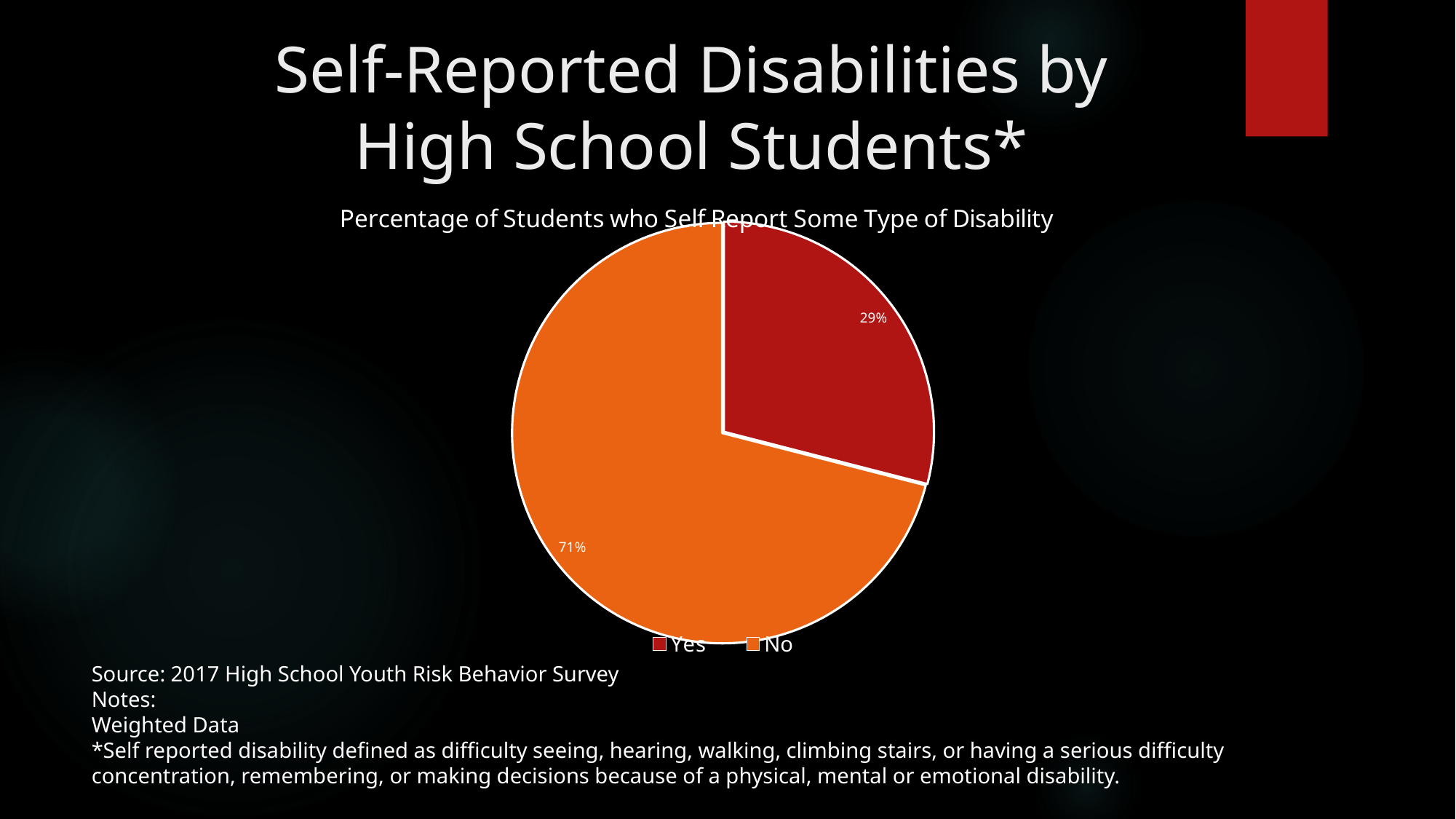
What is the difference in percentage points between the No and Yes slices? 42 Which slice of the pie is the smallest? Yes Which is larger, the Yes slice or the No slice? No How many slices does the pie chart have? 2 What percentage of students do not self-report a disability (No)? 71% What type of chart is shown on the slide? pie chart Which slice of the pie is the largest? No What percentage of students self-report some type of disability (Yes)? 29% What share of the pie does the Yes slice represent? 29% What is the title of the chart? Percentage of Students who Self Report Some Type of Disability How many entries does the legend list? 2 What colour is the Yes slice? red